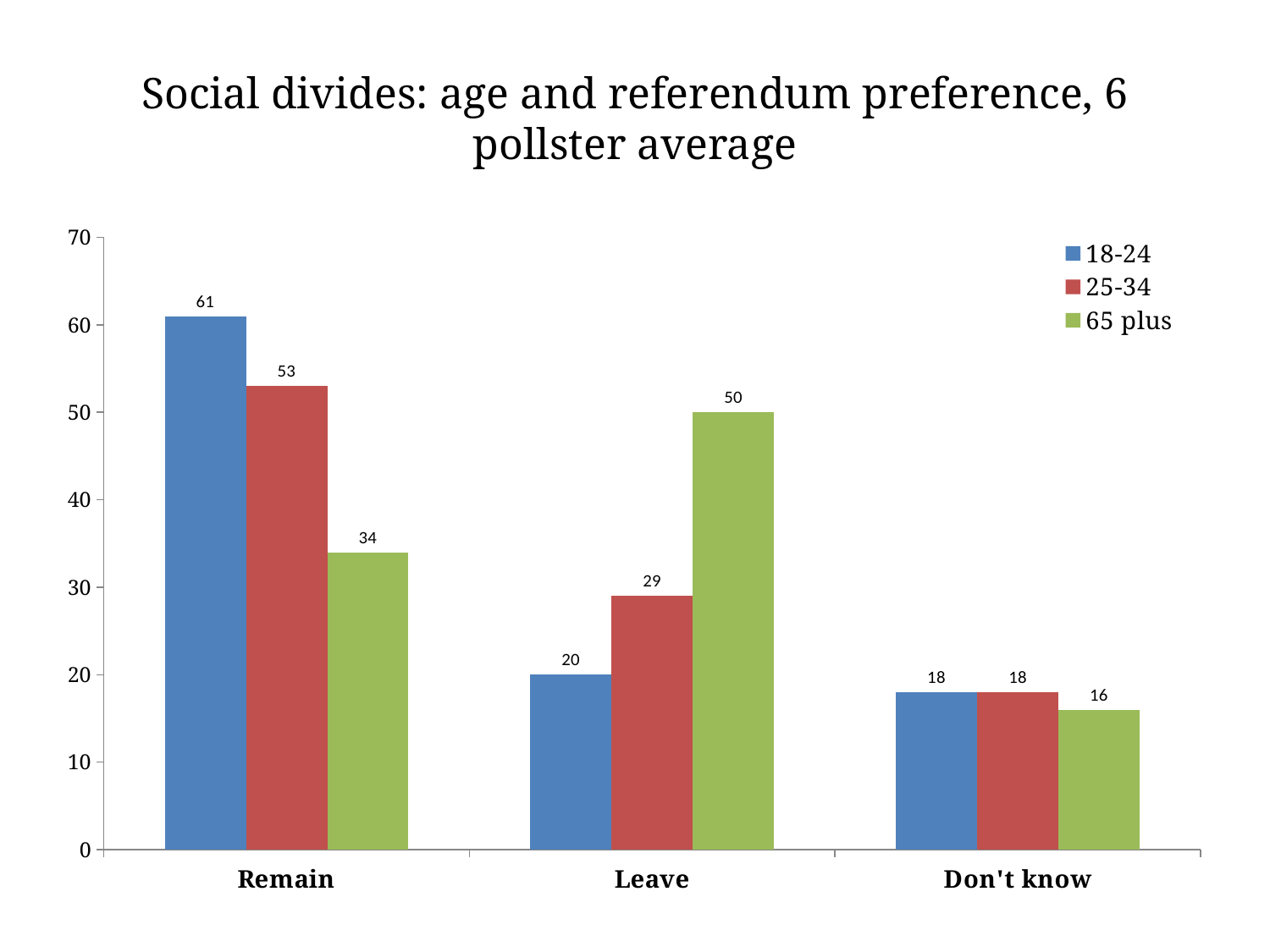
What is the value for the 18-24 series in the Remain category? 61 What kind of chart is shown on the slide? Bar chart Is the value for 25-34 in the Remain category greater or less than 50? greater What is the difference between the 18-24 and 65 plus values in the Remain category? 27 Which is larger in the Leave category: the 25-34 value or the 65 plus value? 65 plus How many categories are shown on the x axis? 3 What is the value for the 25-34 series in the Don't know category? 18 What is the value for the 65 plus series in the Leave category? 50 Which category has the lowest value for the 18-24 series? Don't know Which category has the highest value for the 65 plus series? Leave How many series does the legend list? 3 What is the title of the chart? Social divides: age and referendum preference, 6 pollster average